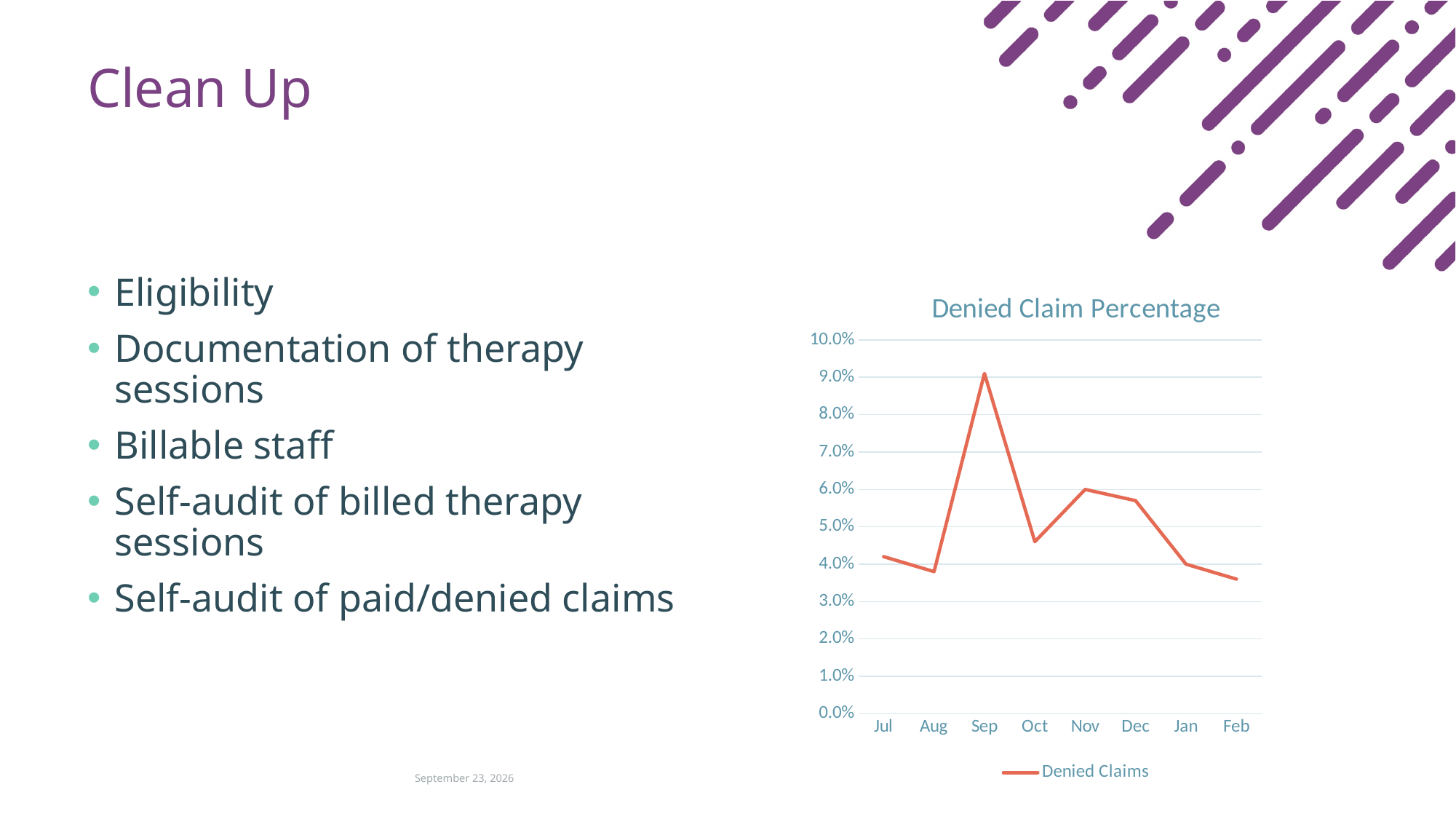
What kind of chart is shown on the slide? line chart What is the name of the series shown in the legend? Denied Claims Is the value for Oct greater or less than 5.0%? less Which month has the larger denied claim percentage, Sep or Oct? Sep In which month is the denied claim percentage highest? Sep Is the value for Sep greater or less than 8.0%? greater How many months are plotted on the x axis? 8 Is the value for Dec greater or less than 5.0%? greater Does the denied claim percentage rise or fall from Nov to Feb? fall How many series does the legend list? 1 What is the title of the chart? Denied Claim Percentage